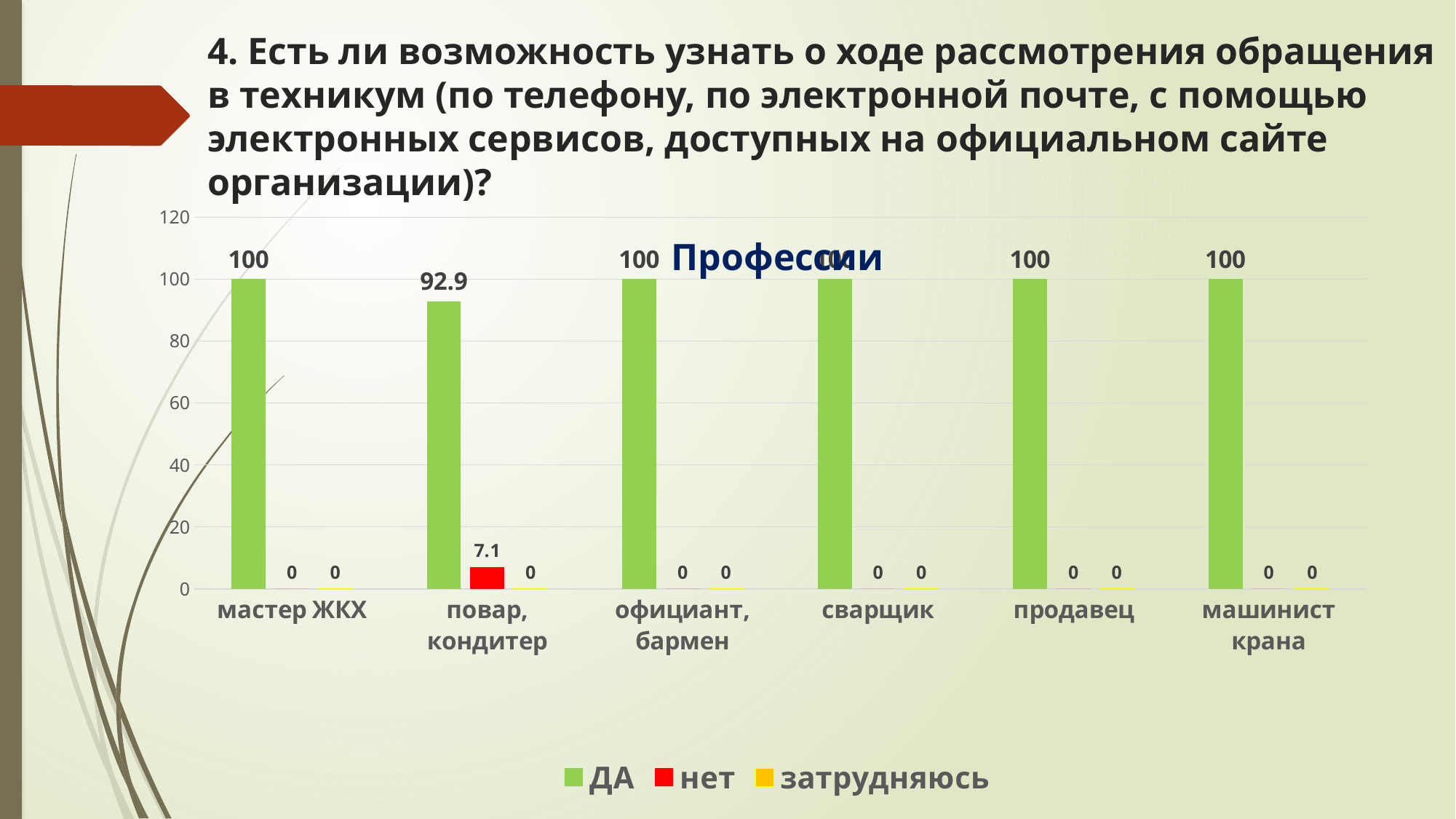
Which colour represents the "нет" series in the legend? red What is the value of the "нет" series for "повар, кондитер"? 7.1 Which category has the highest value in the "нет" series? повар, кондитер What is the value of the "ДА" series for "повар, кондитер"? 92.9 What is the value of the "затрудняюсь" series for "мастер ЖКХ"? 0 What is the difference between the "ДА" values for "мастер ЖКХ" and "повар, кондитер"? 7.1 Which is larger: the "ДА" value for "продавец" or the "ДА" value for "повар, кондитер"? продавец Which category has the lowest value in the "ДА" series? повар, кондитер How many categories are shown on the x axis? 6 What kind of chart is shown on the slide? bar chart How many series does the legend list? 3 What is the value of the "ДА" series for "сварщик"? 100